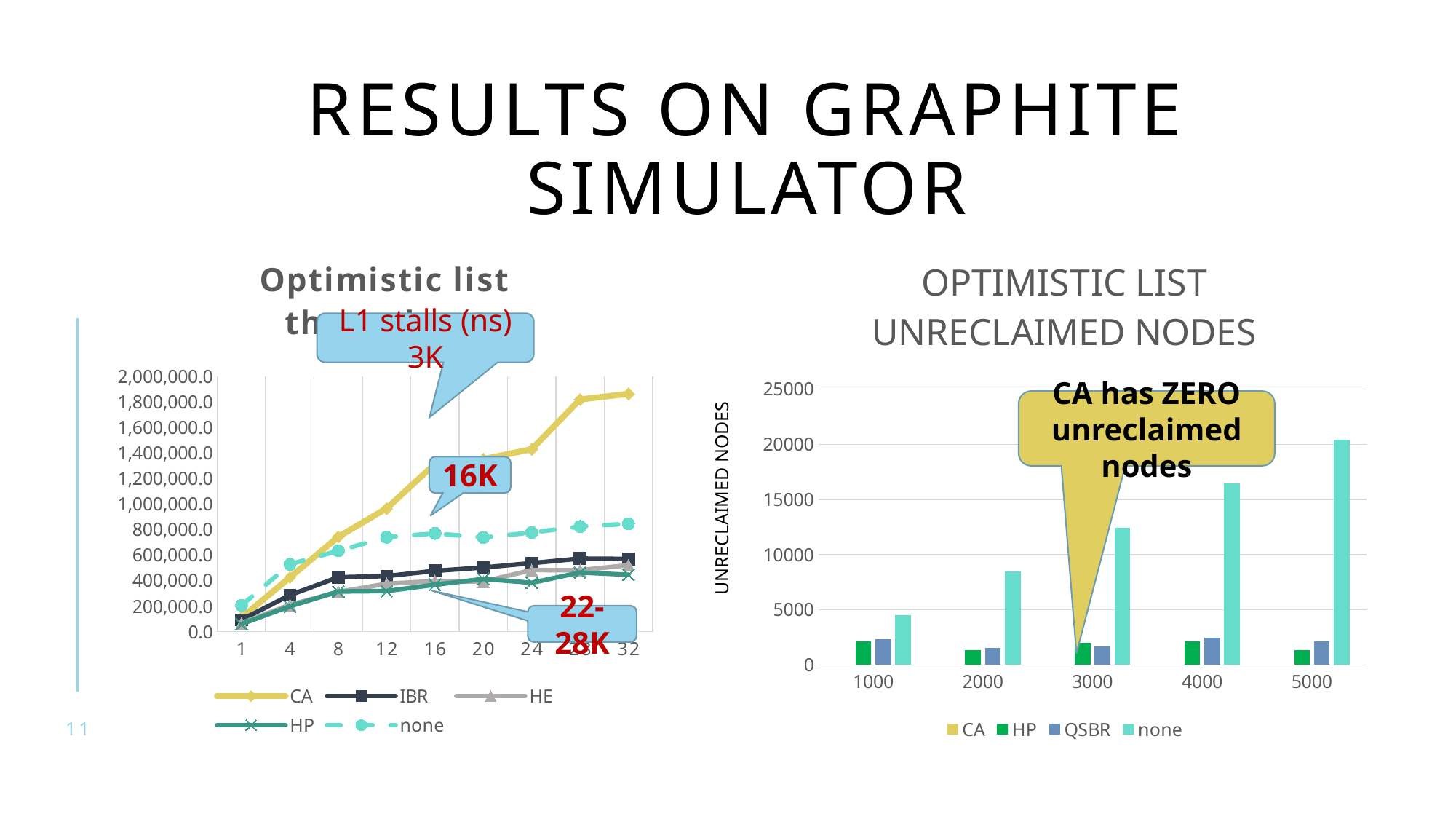
What kind of chart is the chart on the left of the slide? line chart In the 'OPTIMISTIC LIST UNRECLAIMED NODES' chart, which is larger for the 'none' series: the value at 2000 or the value at 3000? 3000 How many points are on the x axis of the chart on the left? 9 How many categories are on the x axis of the 'OPTIMISTIC LIST UNRECLAIMED NODES' chart? 5 In the chart on the left, is the value of CA at x = 32 greater or less than 1,600,000.0? greater In the 'OPTIMISTIC LIST UNRECLAIMED NODES' chart, is the value for 'none' at 5000 greater or less than 15000? greater What kind of chart is the 'OPTIMISTIC LIST UNRECLAIMED NODES' chart? bar chart How many series does the legend of the chart on the left list? 5 In the chart on the left, which series has the highest value at x = 32? CA In the chart on the left, does the CA series rise or fall as the x axis increases? rise How many series does the legend of the 'OPTIMISTIC LIST UNRECLAIMED NODES' chart list? 4 In the 'OPTIMISTIC LIST UNRECLAIMED NODES' chart, which series has the highest value at 5000? none